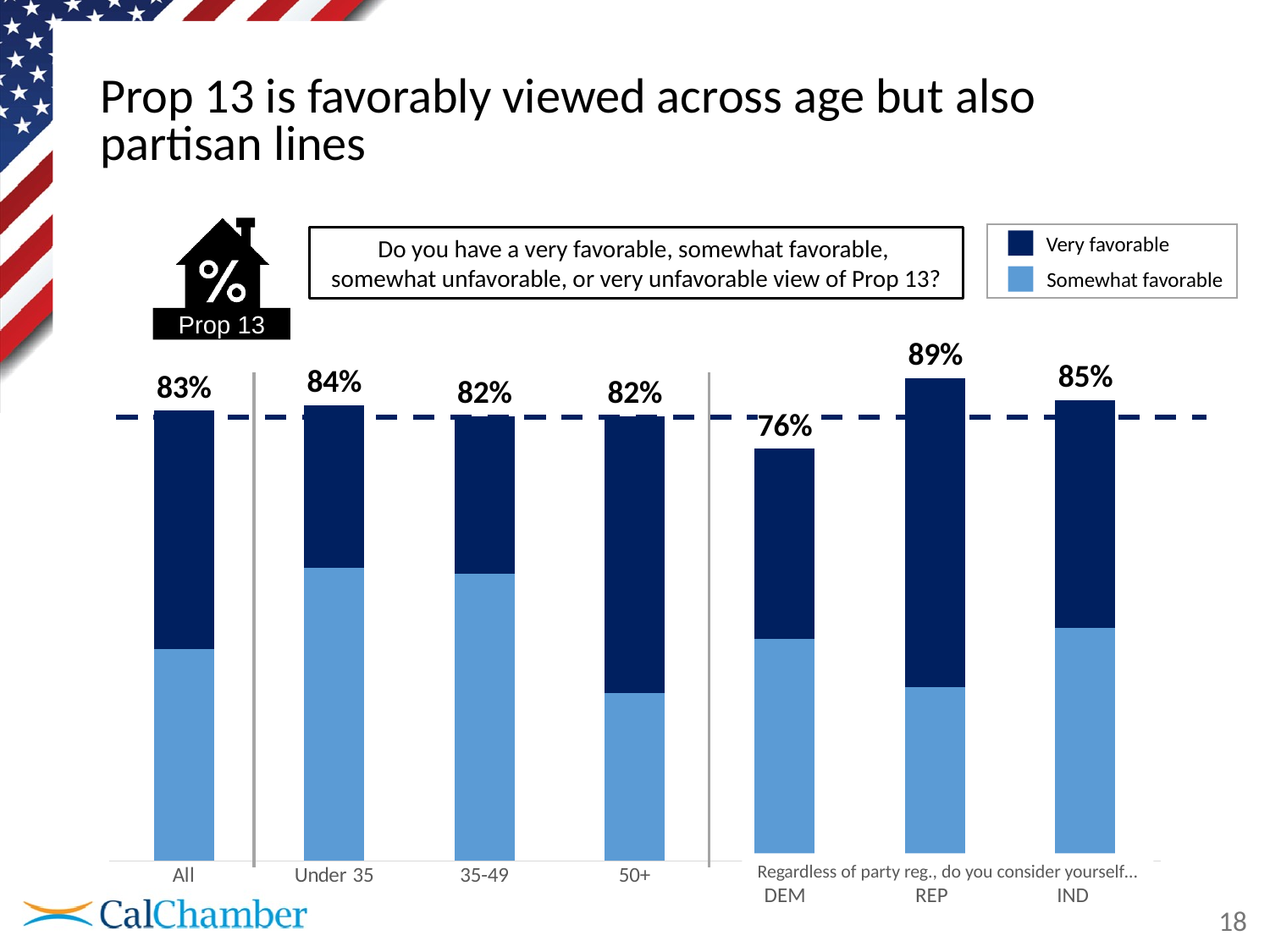
Which category has the lowest total favorable percentage? DEM What are the two series named in the legend? Very favorable and Somewhat favorable What is the difference in total favorable percentage between REP and DEM? 13 percentage points What is the total favorable percentage for REP? 89% How many categories are shown on the x axis of the chart? 7 What is the total favorable percentage for the Under 35 group? 84% What is the total favorable percentage for DEM? 76% Which has a higher total favorable percentage, IND or 50+? IND How many series does the legend list? 2 What is the total favorable percentage for the All category? 83% Which category has the highest total favorable percentage? REP What kind of chart is shown on the slide? Stacked bar chart